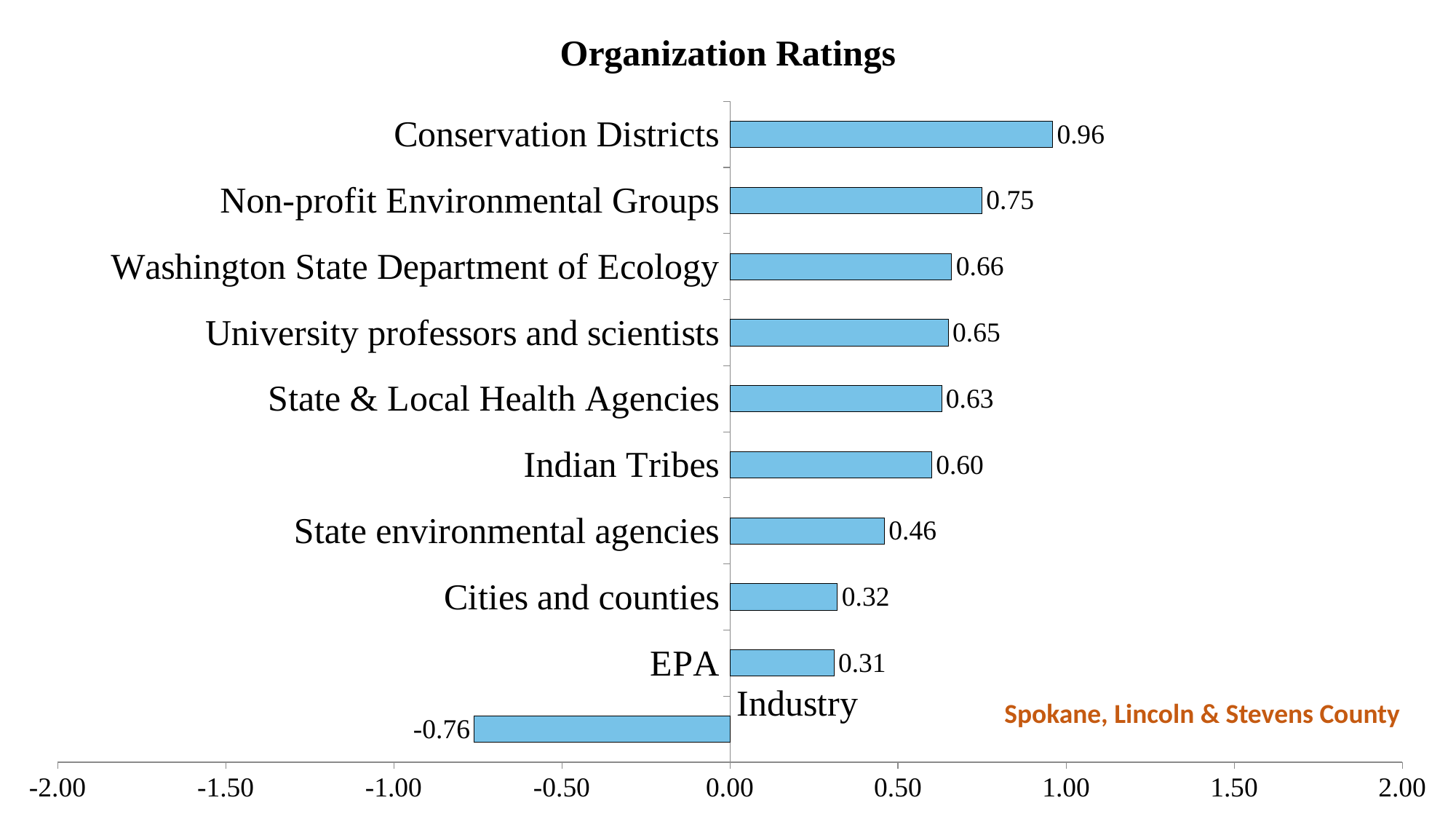
Which organization has the highest rating? Conservation Districts What is the difference between the ratings for Conservation Districts and Non-profit Environmental Groups? 0.21 How many organizations are shown in the chart? 10 Which has a higher rating, State environmental agencies or Cities and counties? State environmental agencies What kind of chart is this? bar chart Which organization has the lowest rating? Industry What is the rating for Industry? -0.76 What is the rating for Indian Tribes? 0.60 Is the rating for Washington State Department of Ecology greater or less than 0.50? greater What is the difference between the ratings for Cities and counties and EPA? 0.01 What is the rating for Conservation Districts? 0.96 What is the title of the chart? Organization Ratings